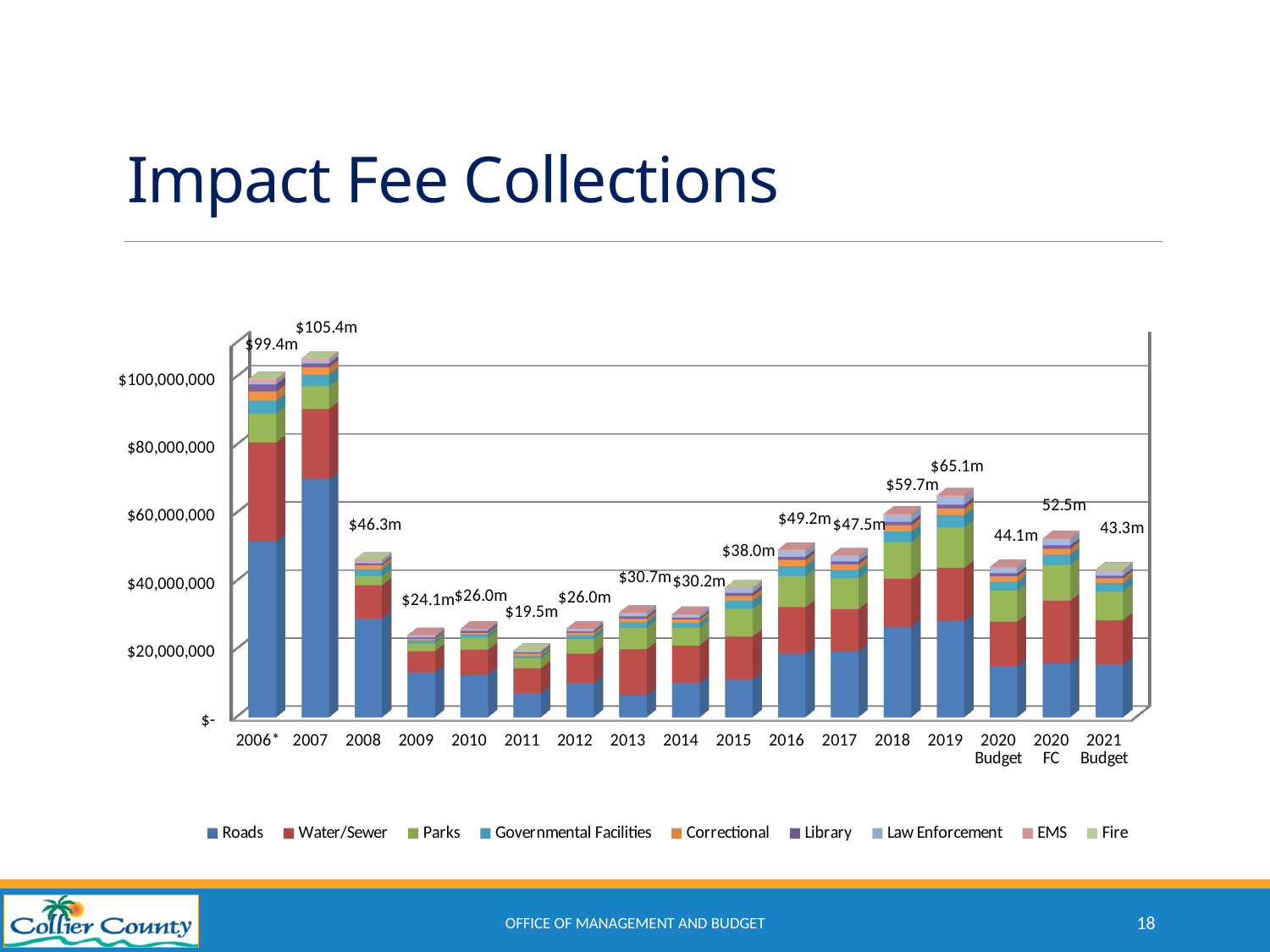
Which year has the highest total impact fee collections? 2007 Which year has the lowest total impact fee collections? 2011 How many year categories are shown on the x axis? 17 How many series does the legend list? 9 Which is larger, the total for 2016 or the total for 2017? 2016 What kind of chart is shown on the slide? Stacked bar chart Is the total for 2008 greater or less than $40,000,000? greater Which series is shown at the bottom of each stacked bar? Roads What is the total labeled for the 2020 FC bar? 52.5m What is the total impact fee collection labeled for 2007? $105.4m What is the difference between the labeled totals for 2019 and 2018? $5.4m What is the total impact fee collection labeled for 2011? $19.5m